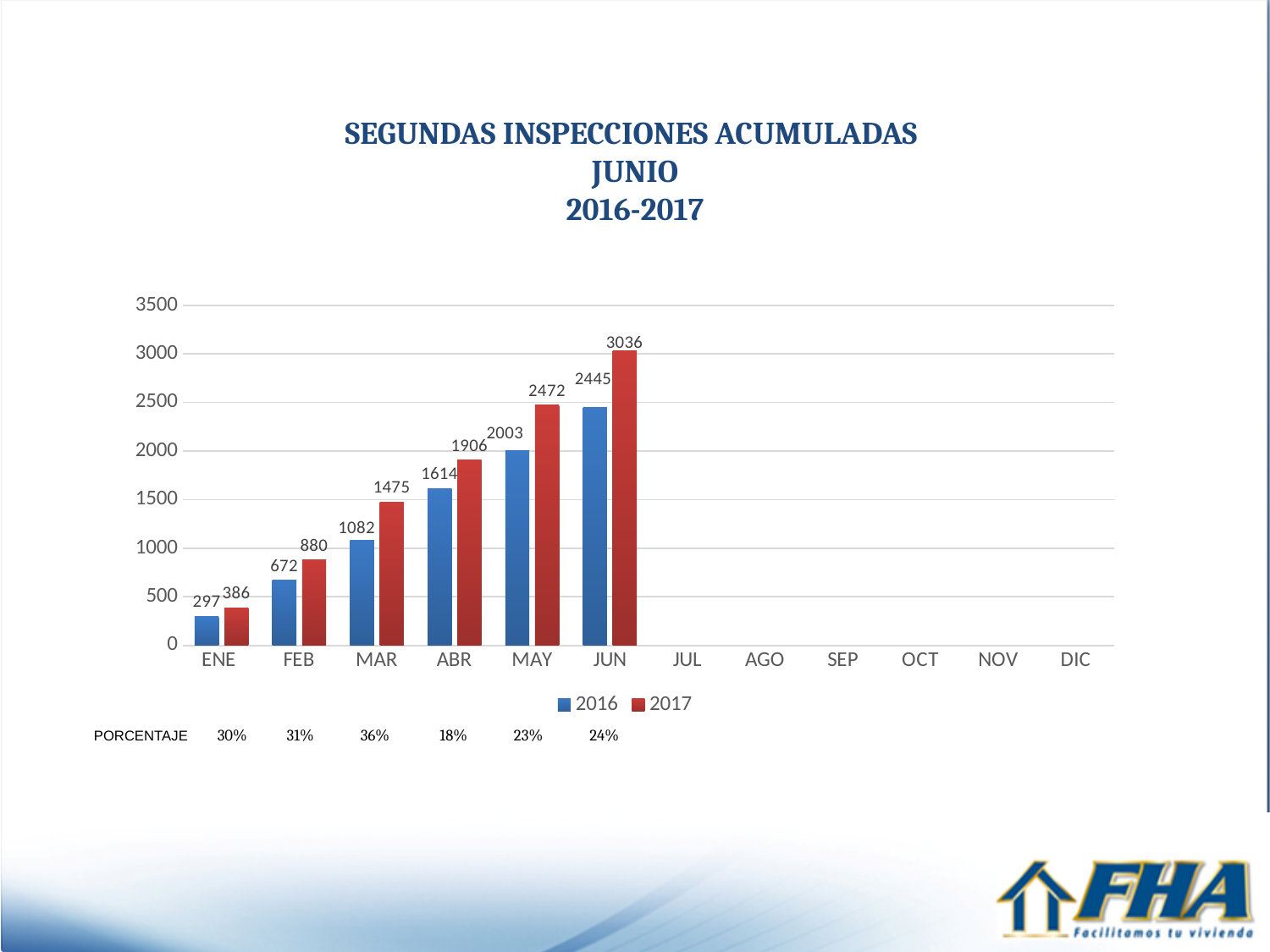
Do the 2017 values rise or fall from ENE to JUN? Rise What is the difference between the 2017 and 2016 values in ABR? 292 Which month has the lowest value for the 2017 series? ENE What is the difference between the 2017 and 2016 values in MAY? 469 What is the value for 2016 in MAR? 1082 What kind of chart is shown on the slide? Bar chart How many series does the legend list? 2 What is the value for 2017 in ENE? 386 How many month categories are shown on the x axis? 12 Which month has the highest value for the 2016 series? JUN Which is larger in FEB, the 2016 value or the 2017 value? 2017 What is the value for 2017 in JUN? 3036